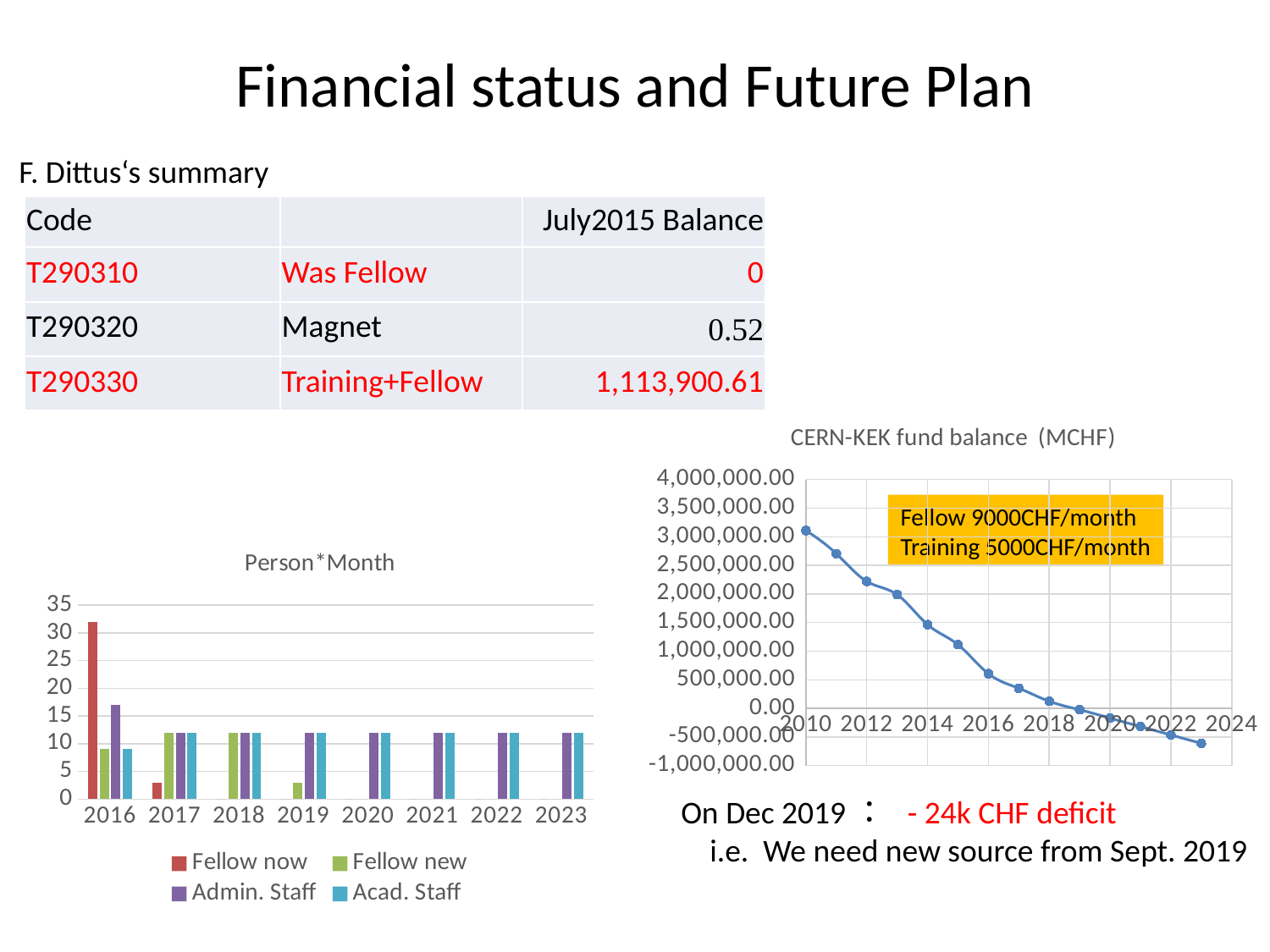
How many year categories are shown on the x axis of the Person*Month chart? 8 How many series does the legend of the Person*Month chart list? 4 In the CERN-KEK fund balance (MCHF) chart, is the value for 2023 greater or less than 0.00? less What kind of chart is the Person*Month chart? bar chart What text is shown in the orange box on the CERN-KEK fund balance (MCHF) chart? Fellow 9000CHF/month Training 5000CHF/month What kind of chart is the CERN-KEK fund balance (MCHF) chart? line chart In the Person*Month chart, which is larger for 2016: Fellow now or Admin. Staff? Fellow now In the Person*Month chart, is the Fellow now value for 2016 greater or less than 30? greater In the CERN-KEK fund balance (MCHF) chart, do the values rise or fall from 2010 to 2023? fall In the CERN-KEK fund balance (MCHF) chart, is the value for 2010 greater or less than 3,000,000.00? greater In the Person*Month chart, which year has the highest Fellow now value? 2016